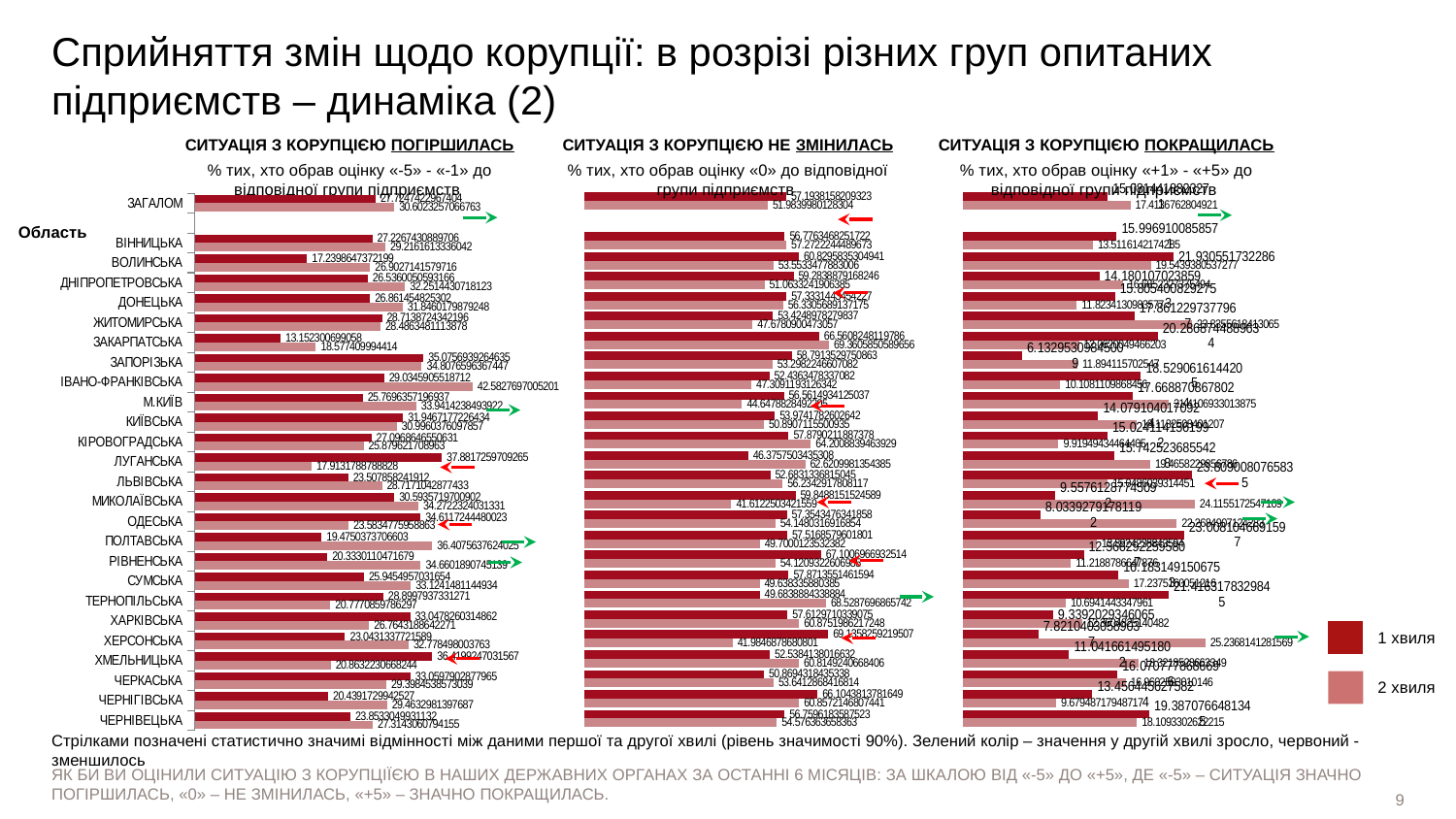
In the chart 'СИТУАЦІЯ З КОРУПЦІЄЮ ПОГІРШИЛАСЬ', which category has the longest bar? ІВАНО-ФРАНКІВСЬКА What kind of chart is used on this slide to show the perception of changes in corruption by region? Bar chart In the chart 'СИТУАЦІЯ З КОРУПЦІЄЮ НЕ ЗМІНИЛАСЬ', for ХЕРСОНСЬКА, which series has the larger value, 1 хвиля or 2 хвиля? 1 хвиля In the chart 'СИТУАЦІЯ З КОРУПЦІЄЮ ПОКРАЩИЛАСЬ', for ХЕРСОНСЬКА, which series has the larger value, 1 хвиля or 2 хвиля? 2 хвиля In the chart 'СИТУАЦІЯ З КОРУПЦІЄЮ НЕ ЗМІНИЛАСЬ', for ТЕРНОПІЛЬСЬКА, which series has the larger value, 1 хвиля or 2 хвиля? 2 хвиля How many charts are shown on the slide? 3 In the chart 'СИТУАЦІЯ З КОРУПЦІЄЮ ПОГІРШИЛАСЬ', how many categories (rows) are plotted, including ЗАГАЛОМ? 26 How many series does the legend list? 2 What are the two series named in the legend? 1 хвиля, 2 хвиля In the chart 'СИТУАЦІЯ З КОРУПЦІЄЮ ПОГІРШИЛАСЬ', which category has the shortest bar? ЗАКАРПАТСЬКА